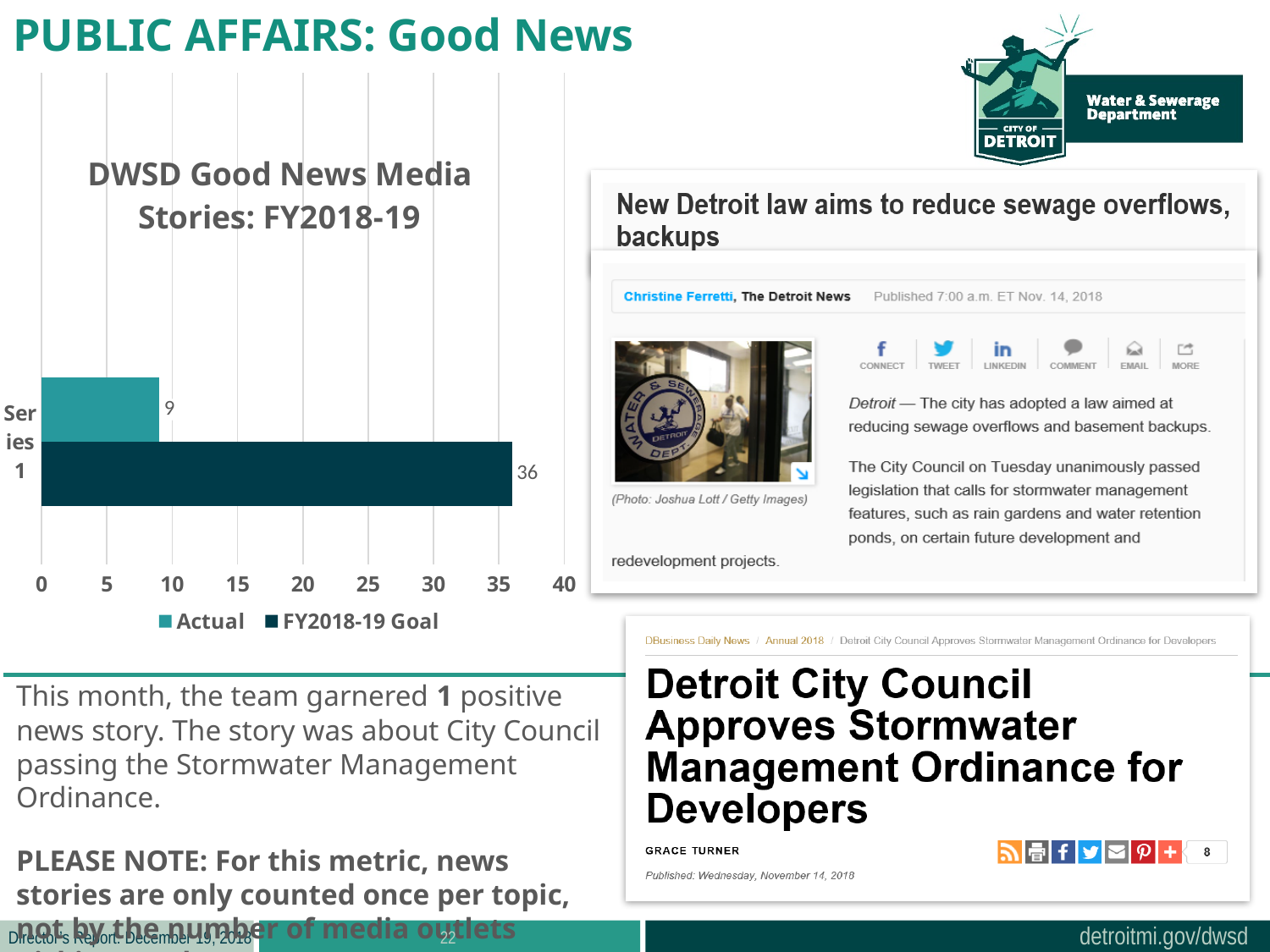
How many series does the legend list? 2 What is the FY2018-19 Goal value in the DWSD Good News Media Stories chart? 36 Which series has the smallest value in the chart? Actual What is the Actual value in the DWSD Good News Media Stories chart? 9 Which series has the larger value, Actual or FY2018-19 Goal? FY2018-19 Goal What is the title of the chart on the slide? DWSD Good News Media Stories: FY2018-19 What type of chart is shown on the slide? bar chart Is the Actual value greater or less than 10? less Is the FY2018-19 Goal value greater or less than 30? greater What is the difference between the FY2018-19 Goal and the Actual value? 27 What is the maximum value shown on the x axis of the chart? 40 Which series has the largest value in the chart? FY2018-19 Goal